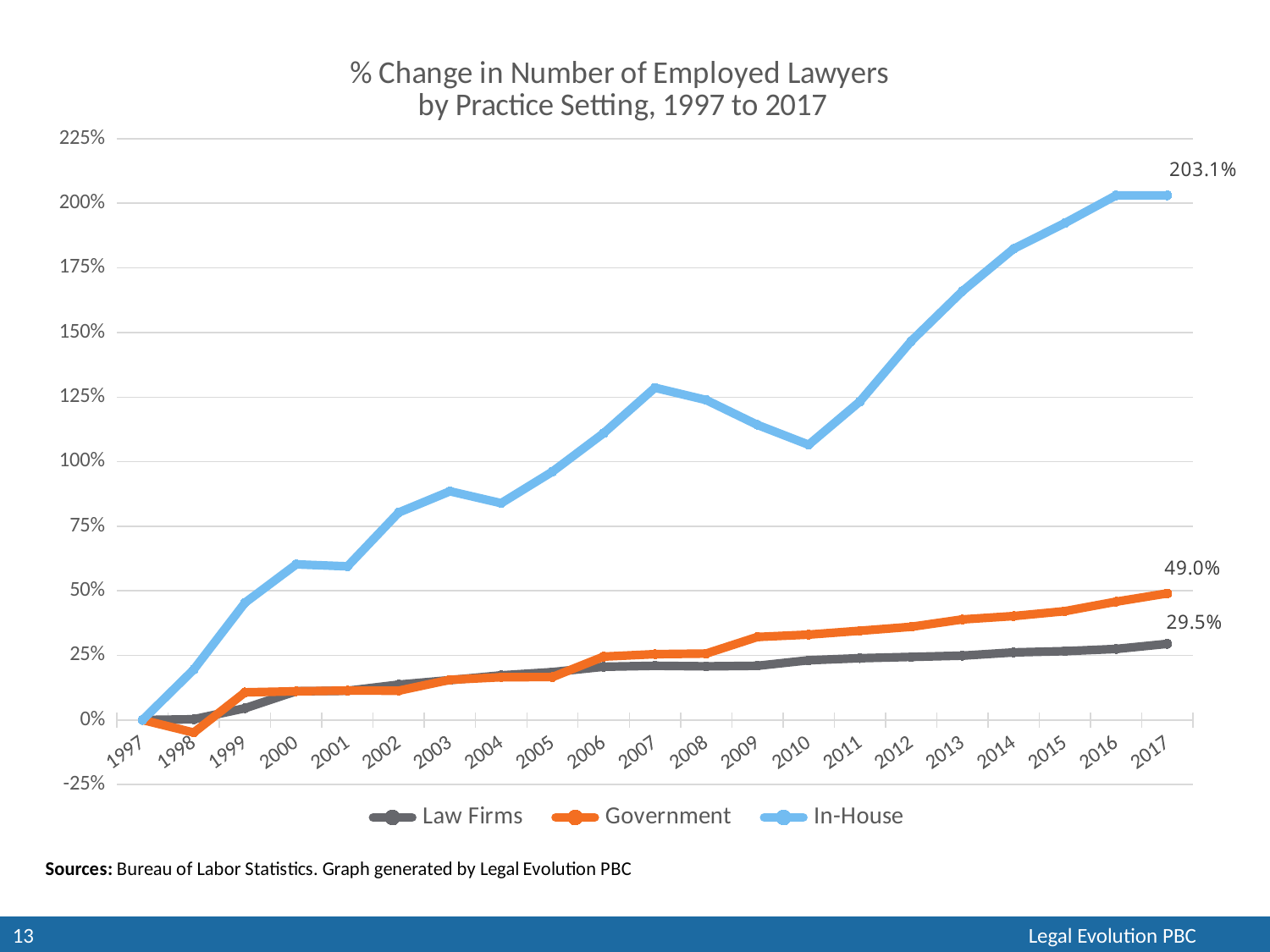
Is the value for In-House in 2003 greater or less than 75%? greater What is the value for In-House in 2017? 203.1% Which practice setting has the lowest value in 2017? Law Firms What is the value for Government in 2017? 49.0% How many series does the legend list? 3 What is the difference between the Government and Law Firms values in 2017? 19.5% What is the value for Law Firms in 2017? 29.5% Is the value for Government in 2013 greater or less than 50%? less What is the difference between the In-House and Government values in 2017? 154.1% Which practice setting has the highest value in 2017? In-House How many years are shown on the x axis? 21 In 2017, which is larger: the value for Government or the value for Law Firms? Government